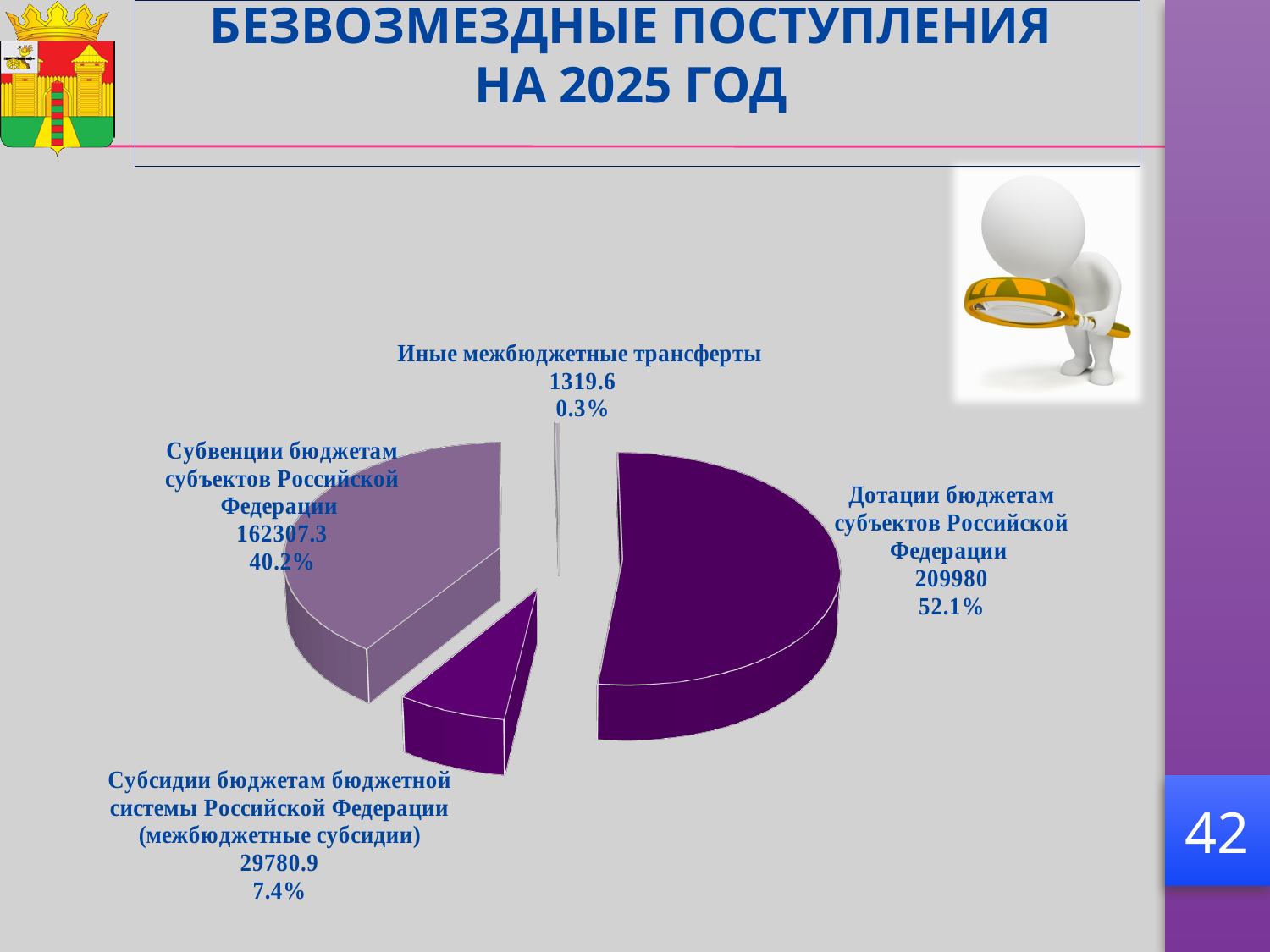
Which category has the largest slice of the pie? Дотации бюджетам субъектов Российской Федерации What is the value shown for Иные межбюджетные трансферты? 1319.6 Which category has the smallest slice of the pie? Иные межбюджетные трансферты What share of the pie does Иные межбюджетные трансферты represent? 0.3% What is the value shown for Субсидии бюджетам бюджетной системы Российской Федерации (межбюджетные субсидии)? 29780.9 Which is larger: the value for Субсидии бюджетам бюджетной системы Российской Федерации (межбюджетные субсидии) or the value for Иные межбюджетные трансферты? Субсидии бюджетам бюджетной системы Российской Федерации (межбюджетные субсидии) How many categories are shown in the pie chart? 4 What is the difference between the values for Дотации бюджетам субъектов Российской Федерации and Субвенции бюджетам субъектов Российской Федерации? 47672.7 What is the value shown for Субвенции бюджетам субъектов Российской Федерации? 162307.3 What is the value shown for Дотации бюджетам субъектов Российской Федерации? 209980 What kind of chart is shown on the slide? Pie chart What share of the pie does Субвенции бюджетам субъектов Российской Федерации represent? 40.2%